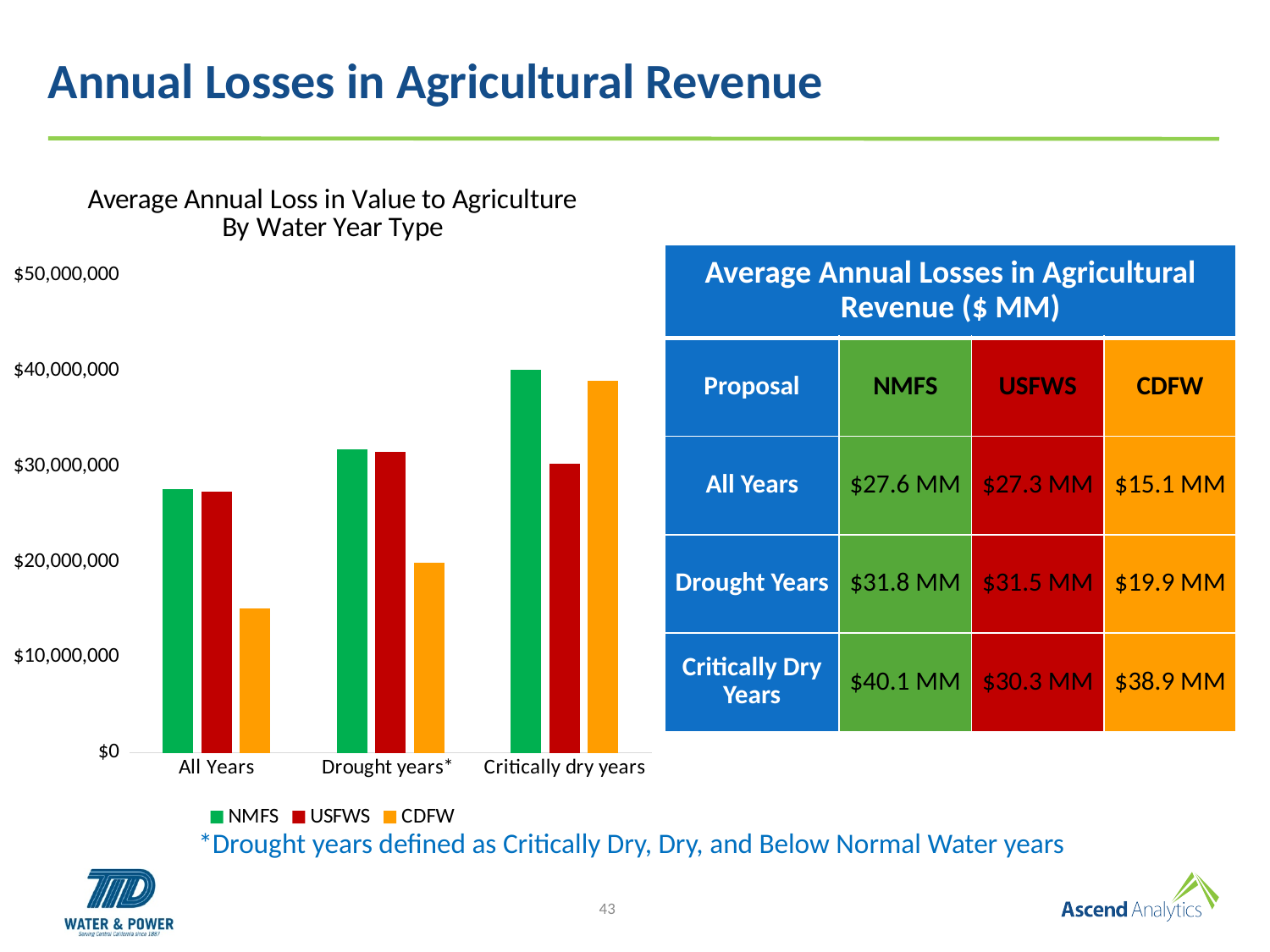
What is the title of the bar chart? Average Annual Loss in Value to Agriculture By Water Year Type Using the table values, what is the difference between the NMFS and CDFW losses for All Years? $12.5 MM Which water year type has the highest NMFS bar? Critically dry years Do the NMFS bars rise or fall moving from All Years to Critically dry years? rise Is the NMFS value for Critically dry years greater or less than $30,000,000? greater Is the CDFW value for All Years greater or less than $20,000,000? less How many water year type categories are shown on the x axis of the chart? 3 What kind of chart is shown on the slide? bar chart Which water year type has the lowest CDFW bar? All Years For Drought years, which is larger, the NMFS bar or the CDFW bar? NMFS How many series does the chart legend list? 3 What is the average annual agricultural revenue loss for USFWS in Critically Dry Years, as shown in the table? $30.3 MM